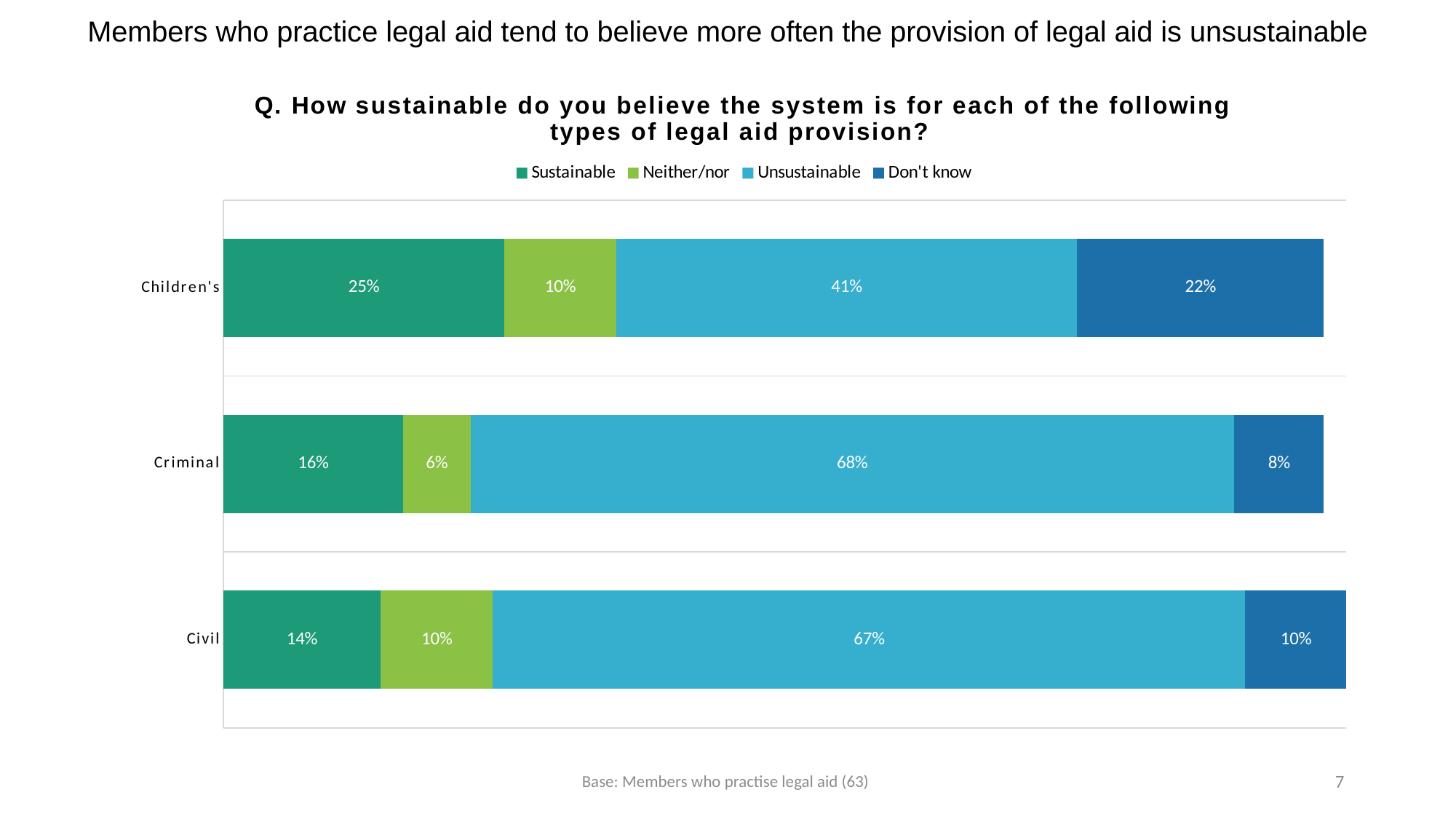
What is the difference between the Unsustainable percentages for Criminal and Children's? 27% What percentage of members said Don't know for Children's legal aid provision? 22% What is the total of the Civil bar? 101% What percentage of members rated Criminal legal aid provision as Unsustainable? 68% How many types of legal aid provision are shown on the chart? 3 What is the base size stated below the chart? 63 Which is larger: the Don't know percentage for Civil or for Criminal? Civil What percentage of members rated Civil legal aid provision as Sustainable? 14% Which type of legal aid provision has the lowest Unsustainable percentage? Children's What kind of chart is shown on the slide? Stacked bar chart How many series does the legend list? 4 Which type of legal aid provision has the highest Sustainable percentage? Children's